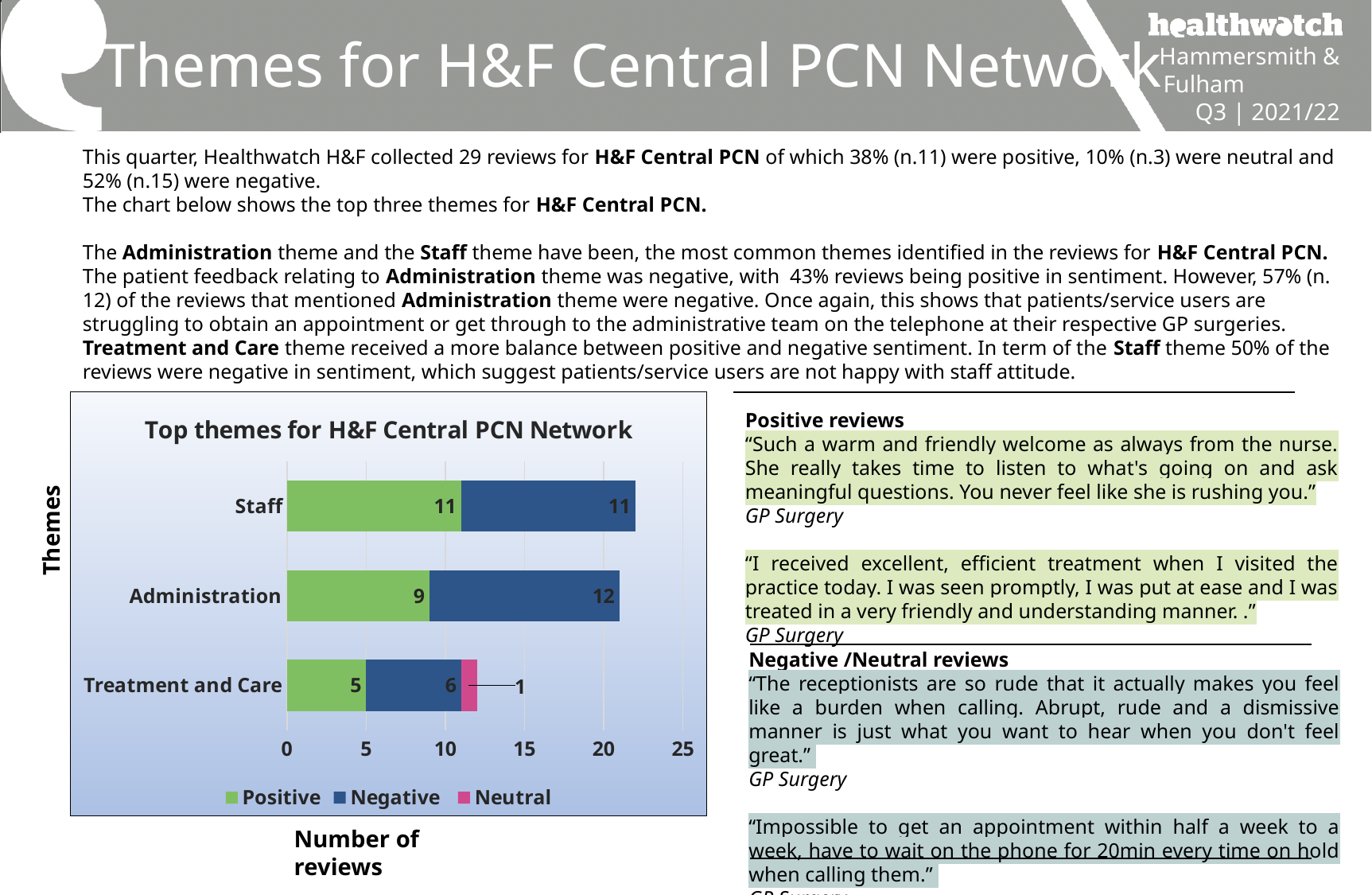
What is the difference between the negative and positive review counts for the Administration theme? 3 How many neutral reviews are shown for the Treatment and Care theme? 1 Which theme has the lowest number of positive reviews? Treatment and Care What is the title of the chart? Top themes for H&F Central PCN Network Which is larger: the number of positive reviews for Administration or for Treatment and Care? Administration Which theme has the highest number of negative reviews? Administration How many positive reviews are shown for the Staff theme? 11 How many negative reviews are shown for the Administration theme? 12 What is the total number of reviews in the Treatment and Care bar? 12 How many series does the chart legend list? 3 What type of chart is shown on the slide? Stacked bar chart How many themes are plotted on the chart? 3